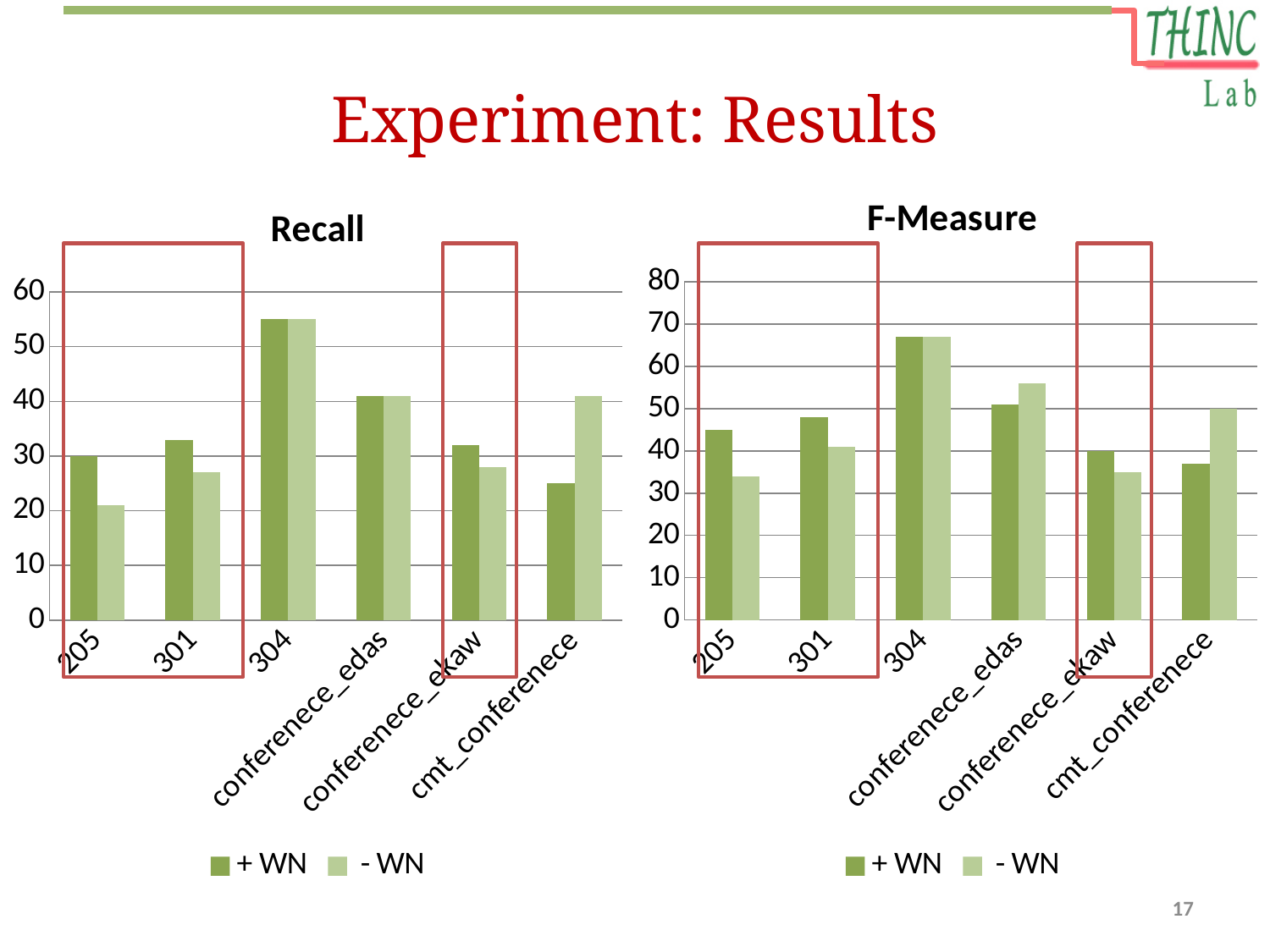
In the F-Measure chart, is the - WN value for conferenece_edas greater or less than 50? greater In the F-Measure chart, for 205, which series has the larger value, + WN or - WN? + WN In the F-Measure chart, is the + WN value for 304 greater or less than 60? greater In the F-Measure chart, which category has the highest - WN bar? 304 How many categories are shown on the x axis of the Recall chart? 6 How many series does the legend of the F-Measure chart list? 2 What are the two legend entries in the F-Measure chart? + WN and - WN In the Recall chart, for cmt_conferenece, which series has the larger value, + WN or - WN? - WN In the Recall chart, is the - WN value for 205 greater or less than 30? less What kind of chart is the Recall chart? bar chart In the Recall chart, which category has the lowest - WN bar? 205 In the Recall chart, which category has the highest + WN bar? 304